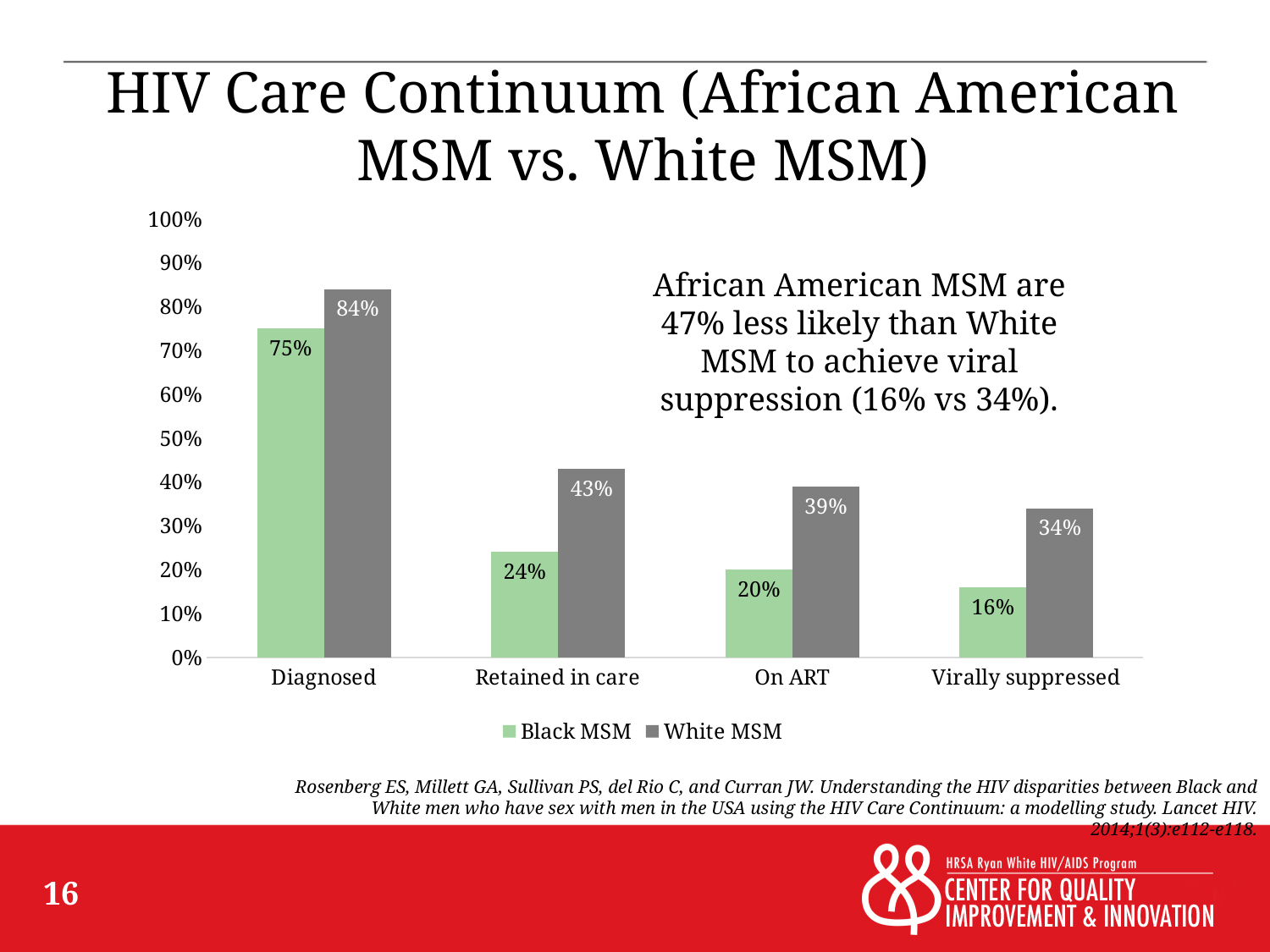
Which is larger in the On ART category, Black MSM or White MSM? White MSM What is the value for Black MSM in the Virally suppressed category? 16% What is the value for White MSM in the On ART category? 39% How many categories are shown on the x axis? 4 What is the value for Black MSM in the Diagnosed category? 75% Which category has the highest value for White MSM? Diagnosed What is the difference between White MSM and Black MSM in the Virally suppressed category? 18% What is the difference between White MSM and Black MSM in the Diagnosed category? 9% What is the value for White MSM in the Retained in care category? 43% How many series does the legend list? 2 What kind of chart is shown on the slide? Bar chart Which category has the lowest value for Black MSM? Virally suppressed